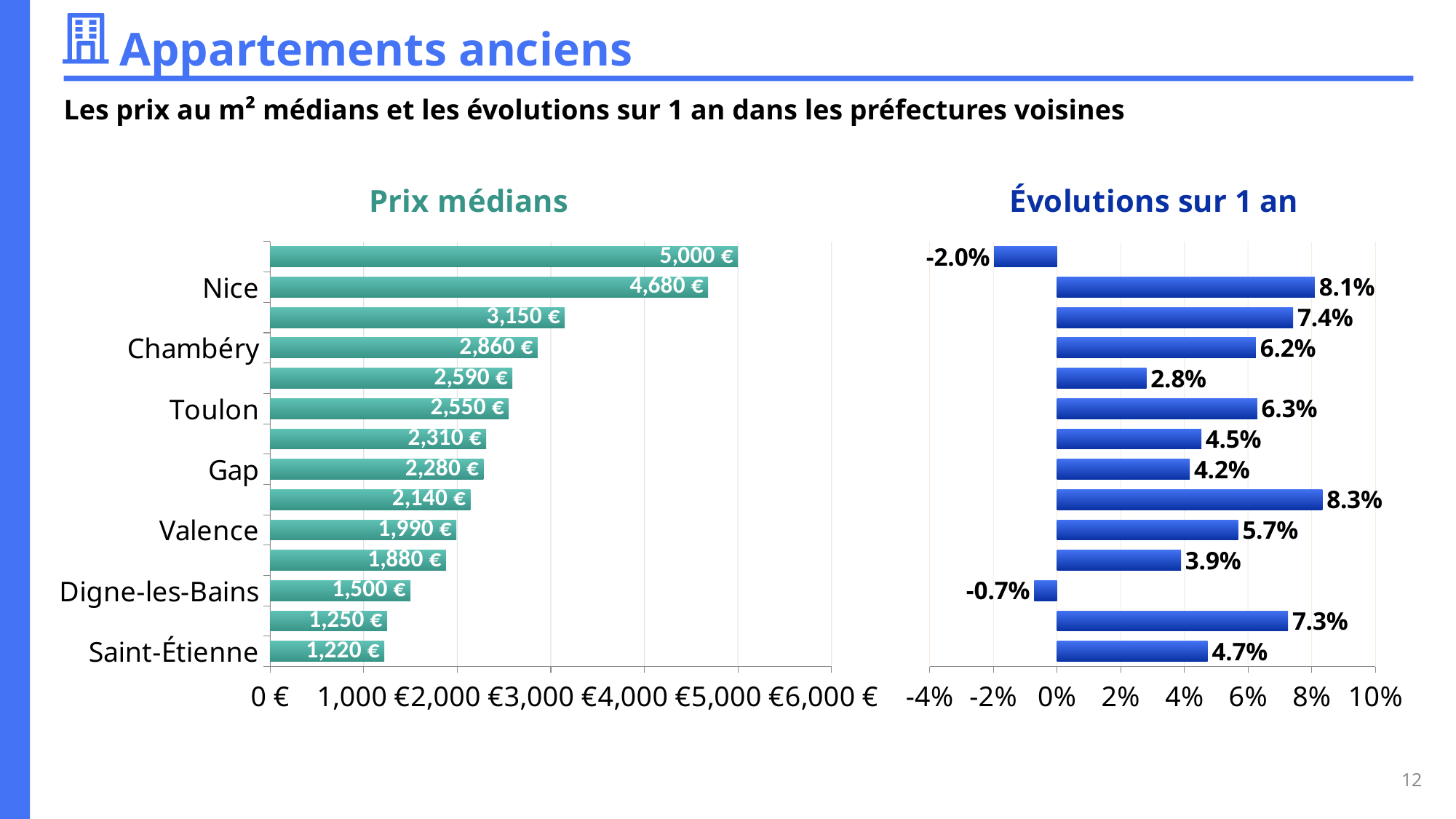
On the 'Évolutions sur 1 an' chart, what is the lowest value shown? -2.0% On the 'Prix médians' chart, what is the median price for Saint-Étienne? 1,220 € How many bars are plotted on the 'Prix médians' chart? 14 On the 'Prix médians' chart, is the value for Valence greater or less than 2,000 €? less On the 'Prix médians' chart, which has a higher median price, Toulon or Gap? Toulon What kind of chart is the 'Évolutions sur 1 an' chart? bar chart On the 'Prix médians' chart, what is the highest value shown on any bar? 5,000 € On the 'Évolutions sur 1 an' chart, what is the highest value shown? 8.3% On the 'Prix médians' chart, what is the difference between the median prices of Nice and Chambéry? 1,820 € On the 'Prix médians' chart, what is the median price for Digne-les-Bains? 1,500 € On the 'Prix médians' chart, what is the median price for Chambéry? 2,860 € On the 'Prix médians' chart, what is the median price for Nice? 4,680 €